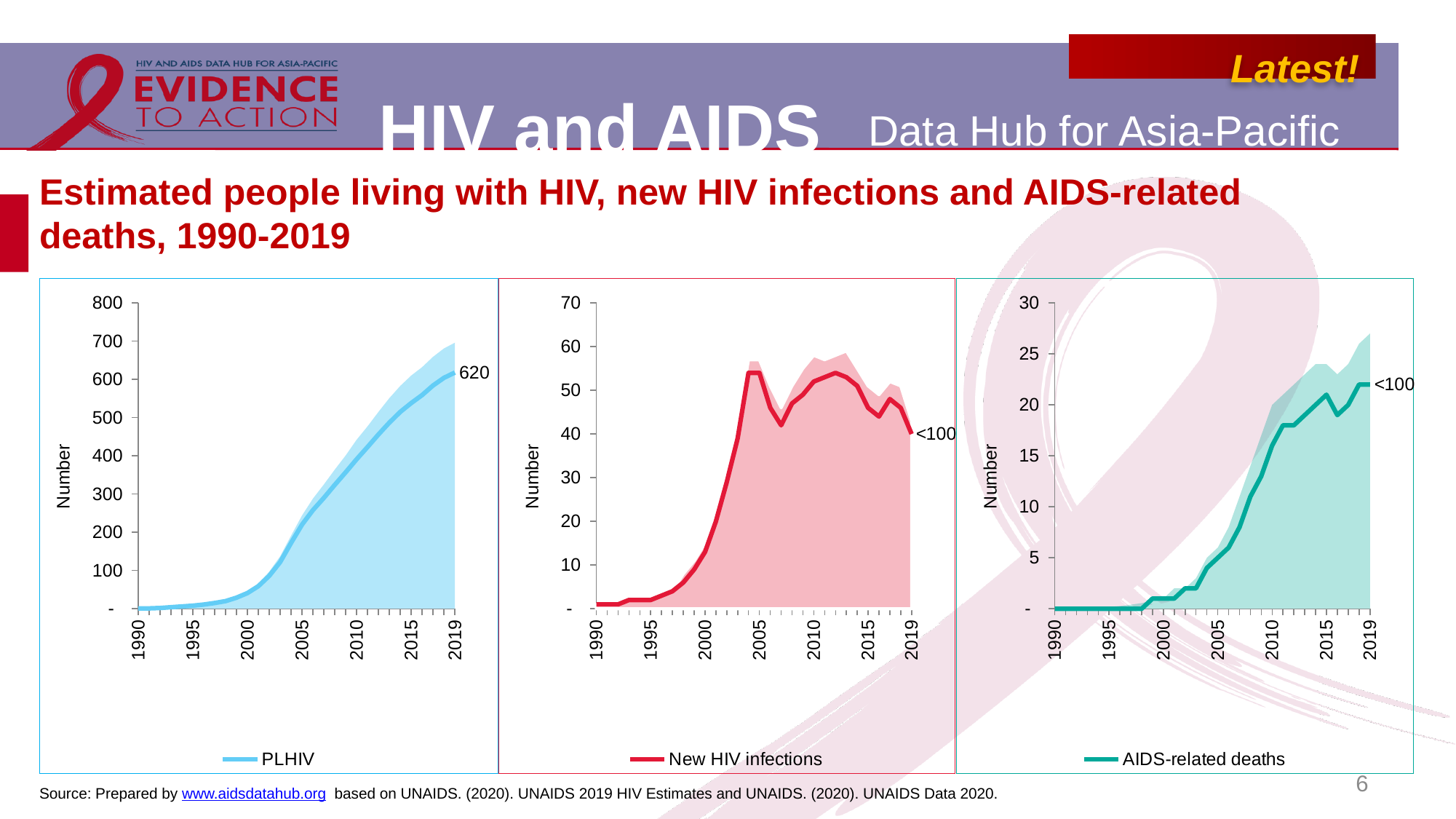
In the right chart (AIDS-related deaths), what label is shown at the end of the line in 2019? <100 In the left chart (PLHIV), is the value for 2005 greater or less than 300? less In the left chart (PLHIV), do the values rise or fall from 1990 to 2019? Rise In the middle chart (New HIV infections), is the value for 2000 greater or less than 20? less How many series does the legend of the middle chart list? 1 In the left chart (PLHIV), what value is labelled at the end of the line in 2019? 620 What is the legend entry of the right chart? AIDS-related deaths In the right chart (AIDS-related deaths), is the value for 2015 greater or less than 15? greater How many charts are shown on the slide? 3 In the middle chart (New HIV infections), do the values rise or fall between 2012 and 2019? Fall In the middle chart (New HIV infections), what label is shown at the end of the line in 2019? <100 What kind of chart is the left chart showing PLHIV? Combination area and line chart (a line with a shaded area band)